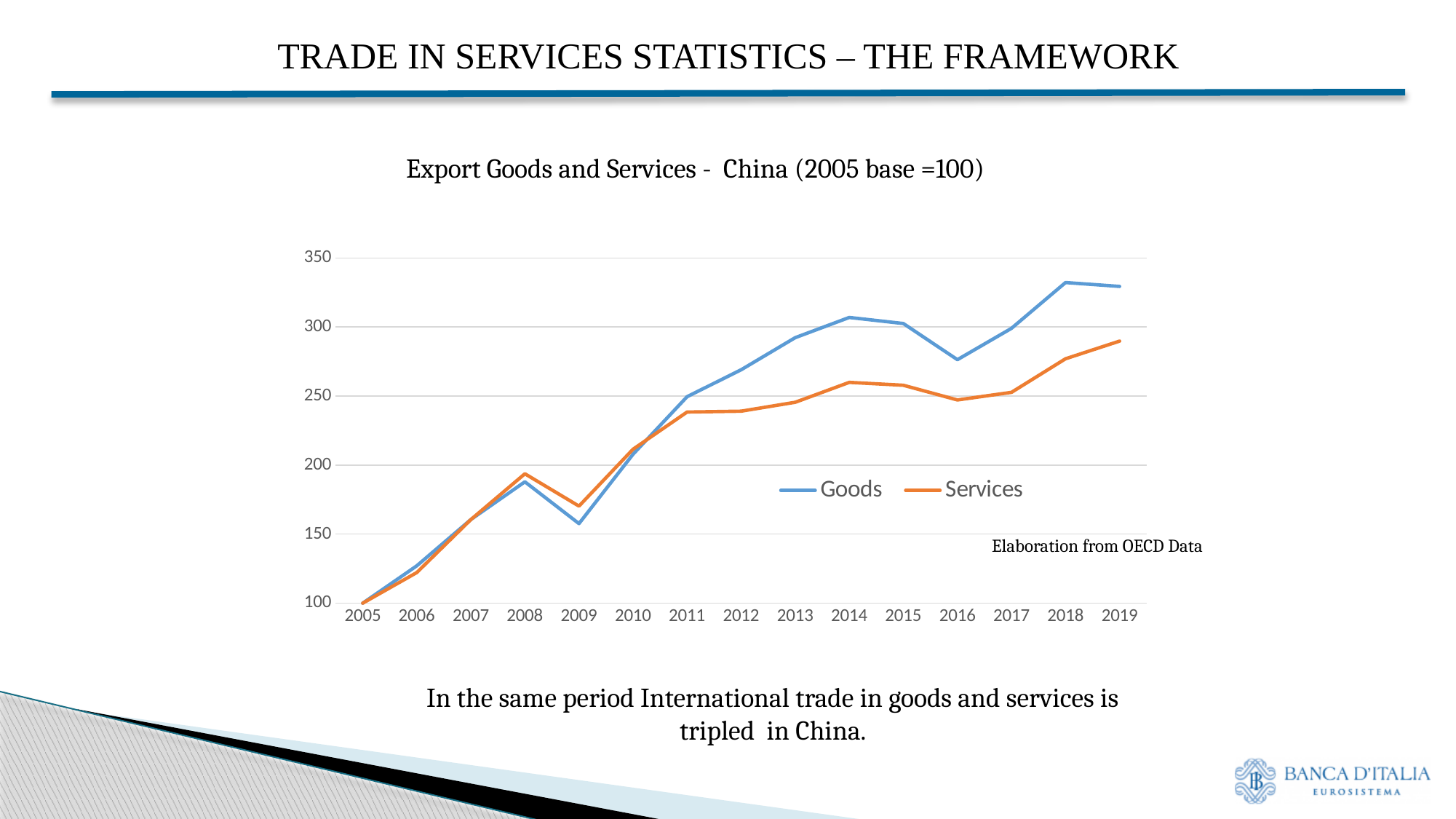
In which year does the Goods series reach its highest value? 2018 Does the Goods series rise or fall between 2014 and 2016? fall What kind of chart is shown on the slide? line chart Is the value for Services in 2019 greater or less than 300? less Is the value for Goods in 2016 greater or less than 250? greater How many years are shown on the x axis? 15 In which year is the Services series at its lowest value? 2005 How many series does the legend list? 2 In which year does the Services series reach its highest value? 2019 Is the value for Goods in 2018 greater or less than 300? greater What is the value of the Goods series in 2005? 100 Which series has the higher value in 2014, Goods or Services? Goods